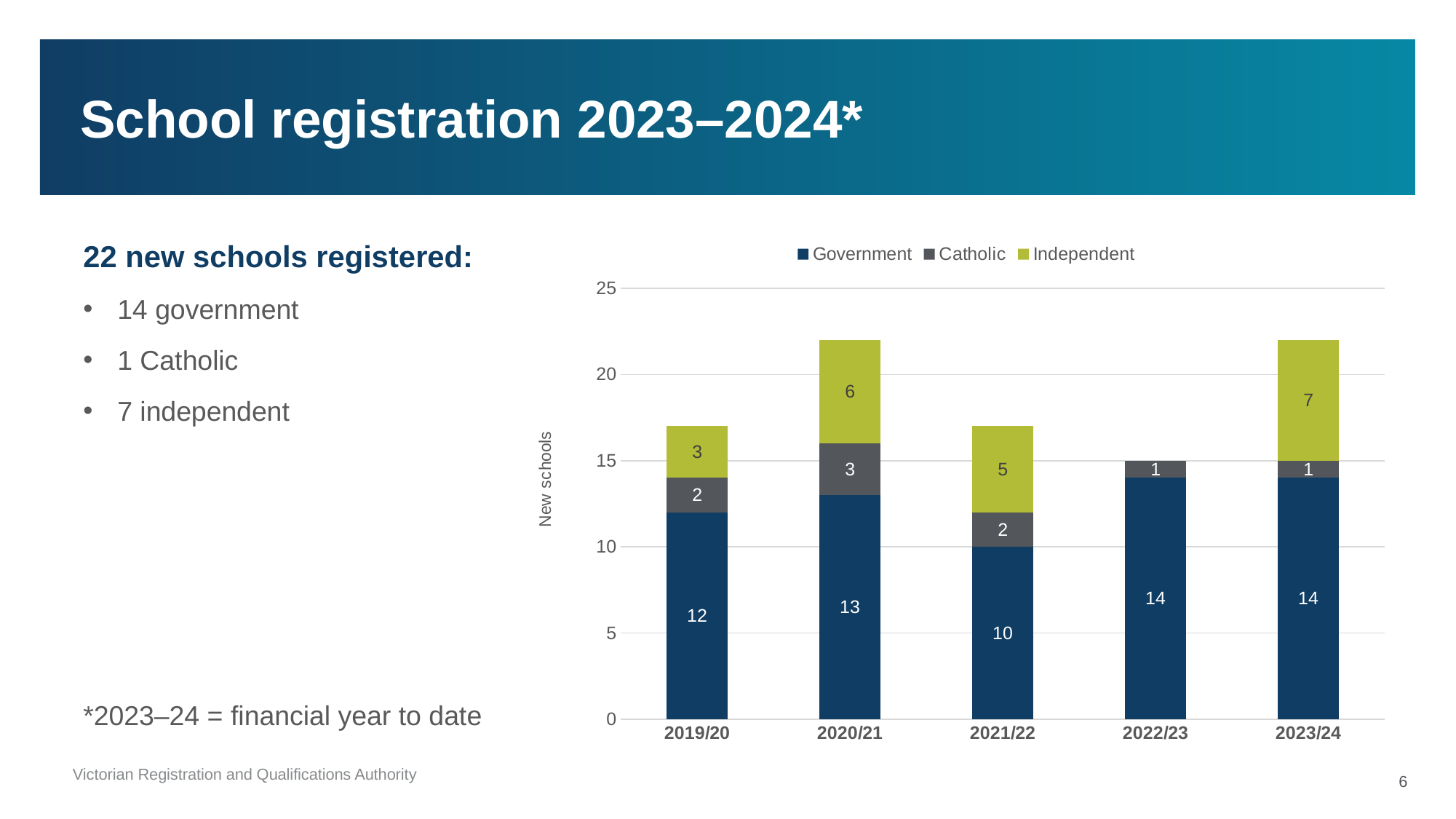
What type of chart is shown on the slide? Stacked bar chart Which is larger, the Independent value for 2021/22 or the Independent value for 2019/20? 2021/22 What is the difference between the Government values for 2023/24 and 2021/22? 4 How many series does the legend list? 3 What is the Catholic value for 2019/20? 2 Which year has the lowest Government value? 2021/22 What is the total of the stacked bar for 2019/20? 17 How many financial years are shown on the x axis? 5 Which year has the highest Independent value? 2023/24 What is the Government value for 2021/22? 10 What is the Independent value for 2020/21? 6 What is the total of the stacked bar for 2022/23? 15